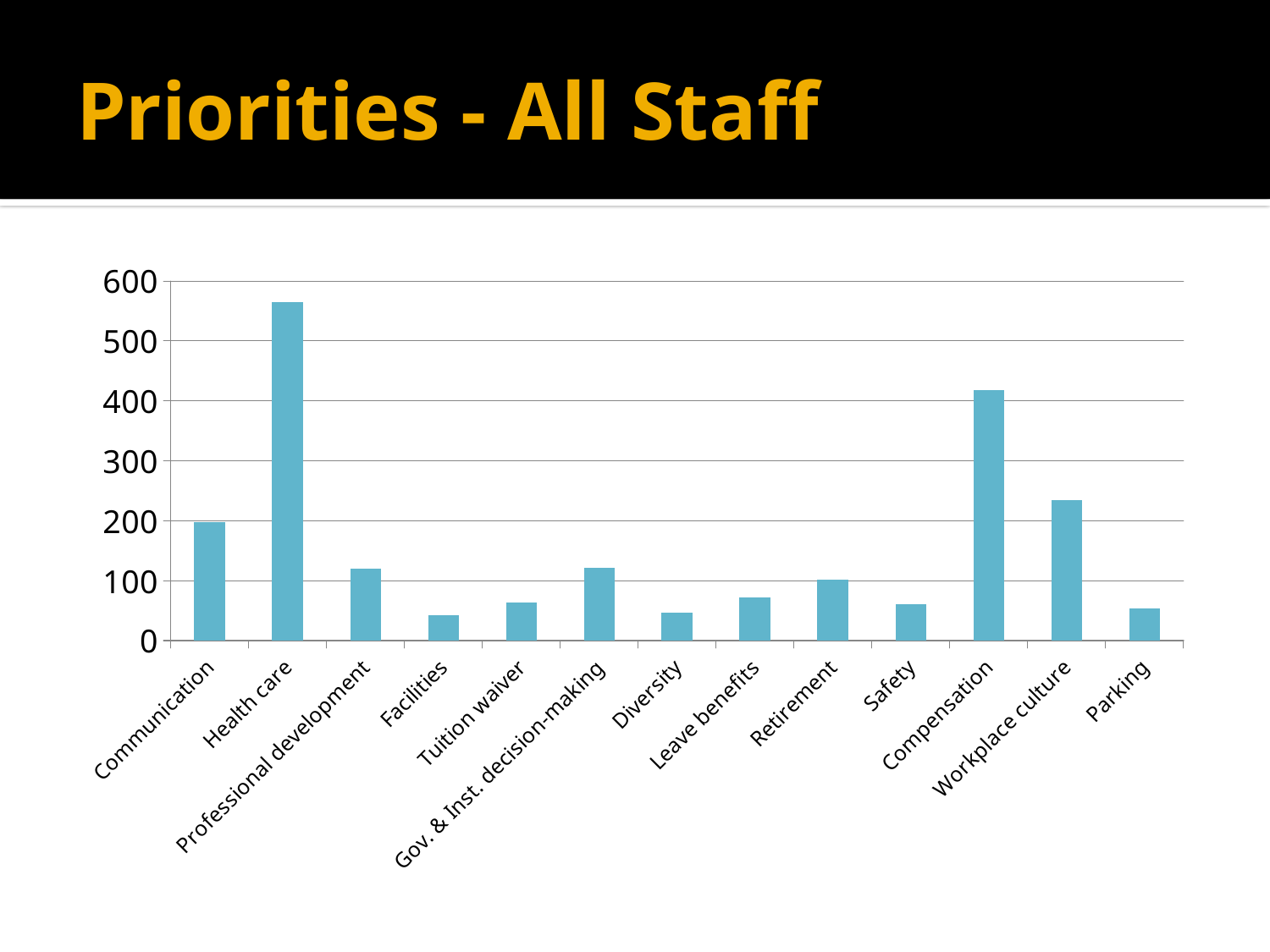
Which is larger, the value for Workplace culture or the value for Communication? Workplace culture Is the value for Workplace culture greater or less than 200? greater Is the value for Facilities greater or less than 100? less Which is larger, the value for Health care or the value for Compensation? Health care What kind of chart is shown on the slide? Bar chart How many categories are plotted on the x axis? 13 What is the title of the slide? Priorities - All Staff What colour are the bars in the chart? Blue Is the value for Compensation greater or less than 400? greater Which category has the highest value? Health care